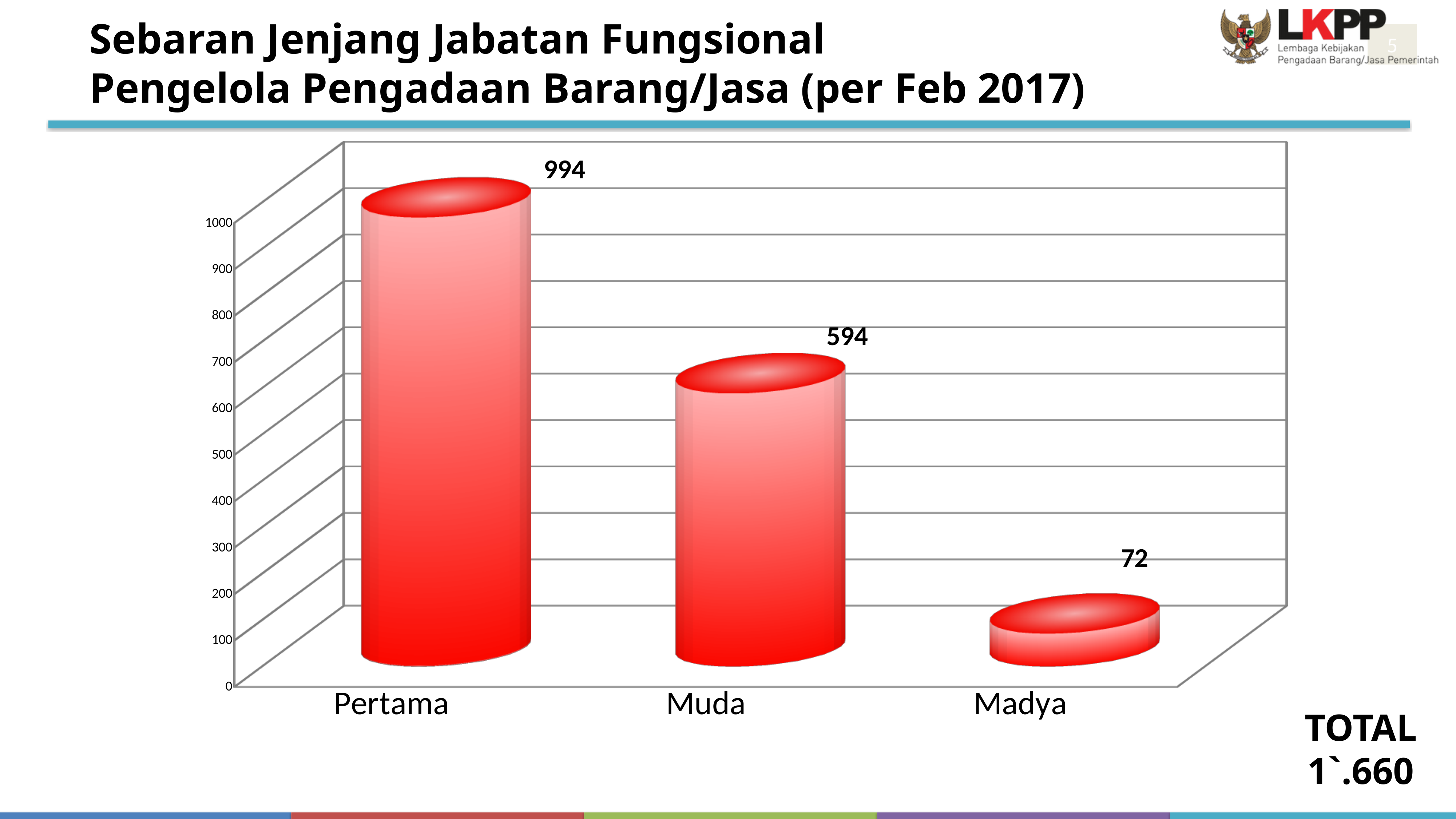
What is the value for Muda? 594 What is the difference between the values for Pertama and Muda? 400 Which category has the highest value? Pertama What kind of chart is shown on the slide? bar chart What is the value for Pertama? 994 Which is larger, the value for Muda or the value for Madya? Muda Is the value for Madya greater or less than 100? less What is the difference between the values for Muda and Madya? 522 Which category has the lowest value? Madya How many categories are shown on the x axis? 3 What is the value for Madya? 72 Do the values rise or fall from Pertama to Madya along the x axis? fall